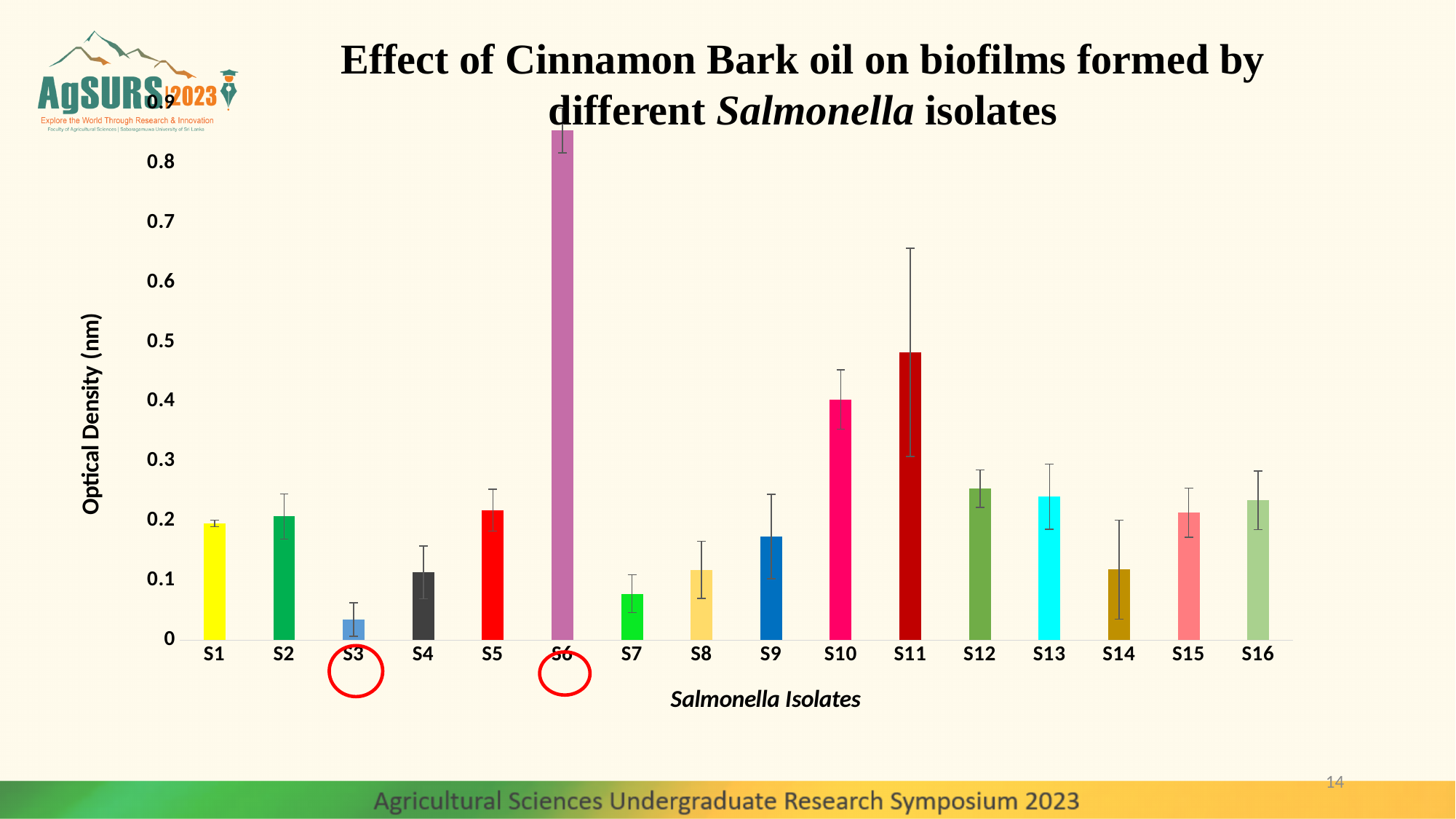
What is the label of the y axis? Optical Density (nm) Is the value for S6 greater or less than 0.8? greater Which isolate has the highest optical density? S6 Which two isolate labels are circled in red on the x axis? S3 and S6 Is the value for S7 greater or less than 0.1? less Which isolate has the lowest optical density? S3 Which has the larger optical density, S3 or S4? S4 Which has the larger optical density, S10 or S11? S11 What kind of chart is shown on the slide? bar chart How many Salmonella isolates are plotted on the x axis? 16 Is the value for S11 greater or less than 0.4? greater